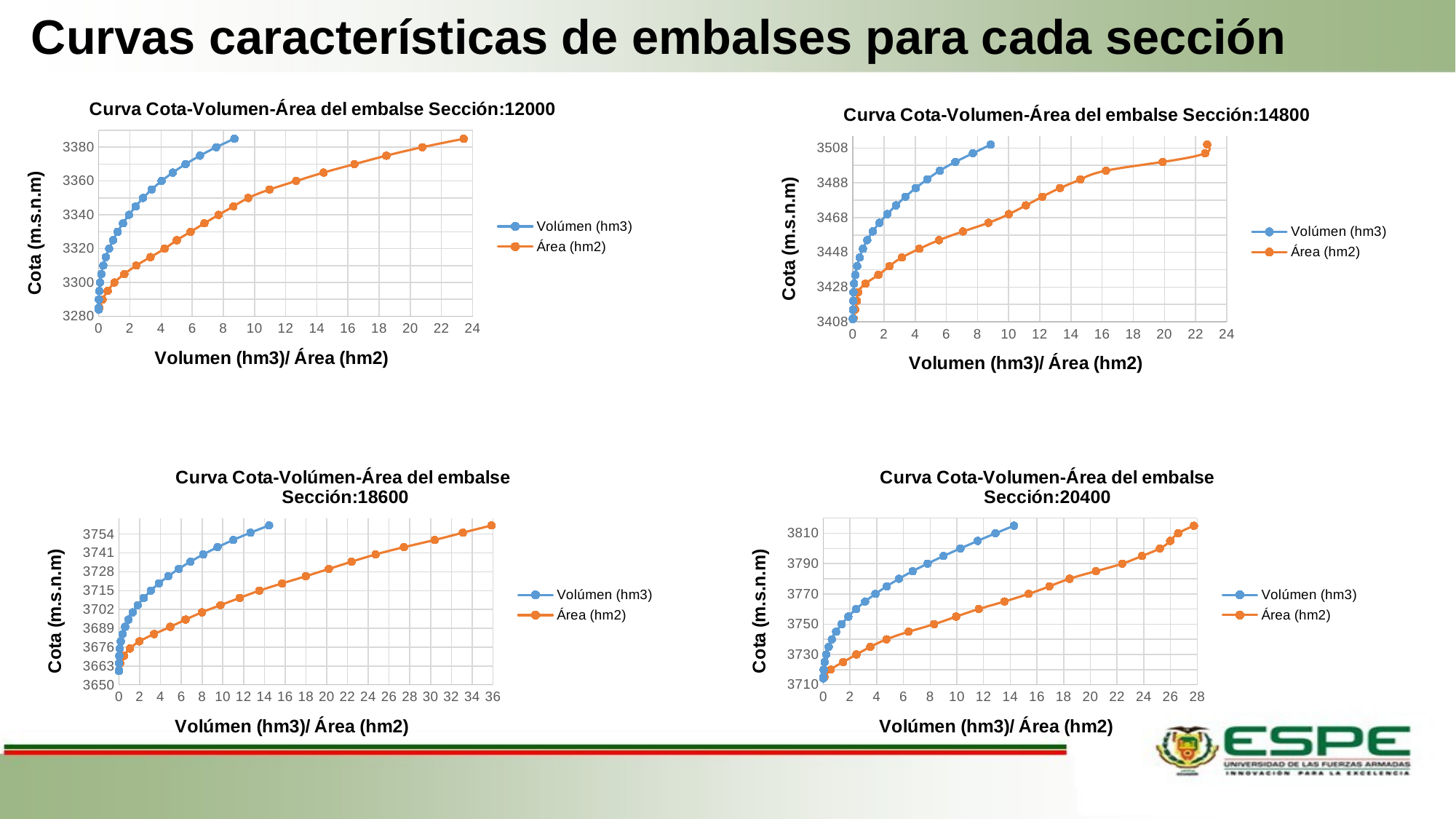
What are the two legend entries in the chart 'Curva Cota-Volúmen-Área del embalse Sección:18600'? Volúmen (hm3) and Área (hm2) What kind of chart is 'Curva Cota-Volumen-Área del embalse Sección:12000'? line chart In the chart 'Curva Cota-Volumen-Área del embalse Sección:14800', is the highest Cota reached by the Volúmen (hm3) series greater or less than 3488? greater In the chart 'Curva Cota-Volumen-Área del embalse Sección:12000', is the largest Volúmen (hm3) value greater or less than 10? less In the chart 'Curva Cota-Volúmen-Área del embalse Sección:18600', is the largest Área (hm2) value greater or less than 34? greater What is the x-axis title of the chart 'Curva Cota-Volumen-Área del embalse Sección:14800'? Volumen (hm3)/ Área (hm2) In the chart 'Curva Cota-Volúmen-Área del embalse Sección:18600', which series reaches the larger value on the x axis, Volúmen (hm3) or Área (hm2)? Área (hm2) How many series does the legend list in the chart 'Curva Cota-Volumen-Área del embalse Sección:14800'? 2 How many charts are shown on the slide? 4 In the chart 'Curva Cota-Volumen-Área del embalse Sección:20400', does the Cota rise or fall as the Volúmen increases along the x axis? rise